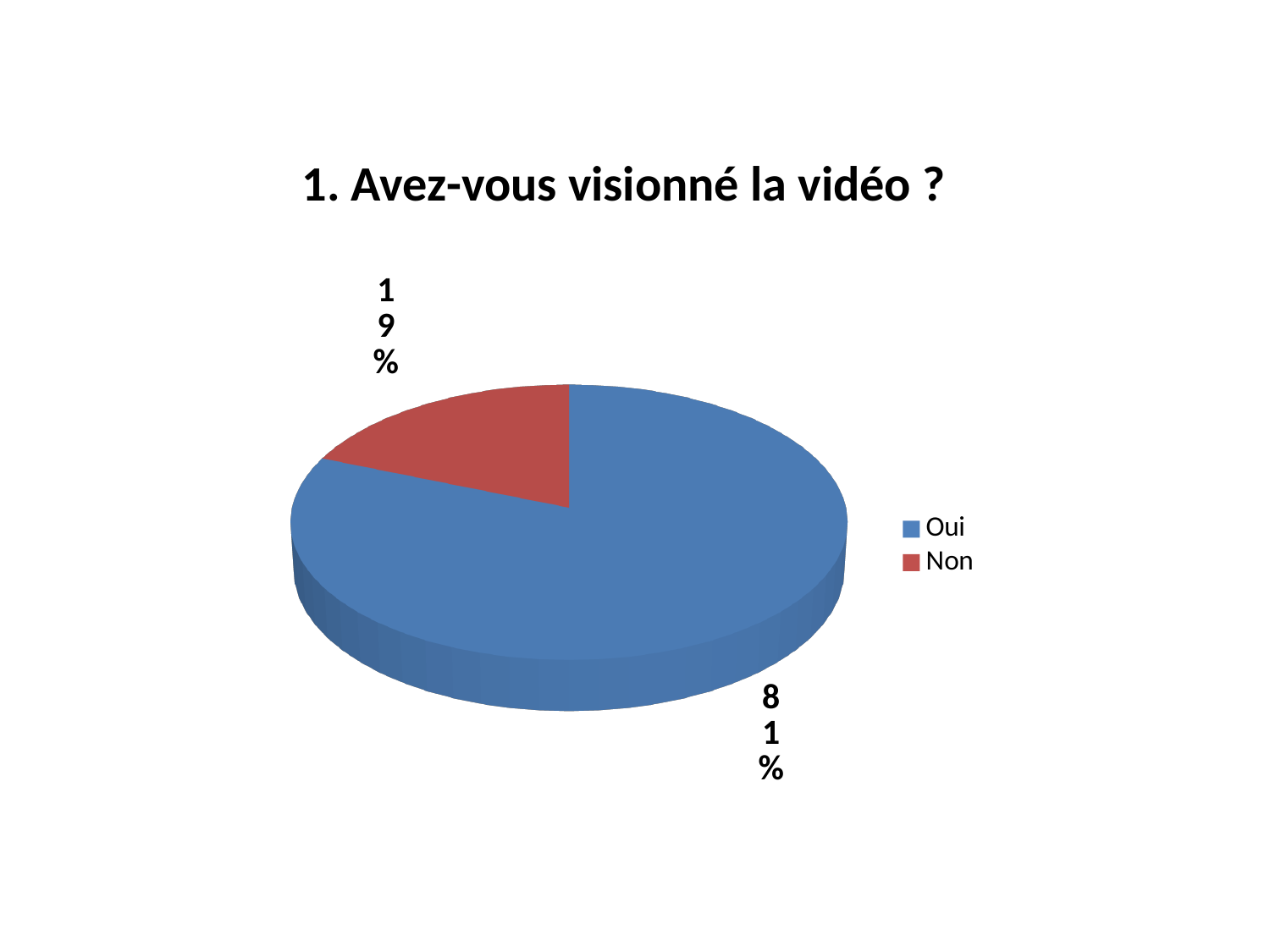
How many categories does the pie chart show? 2 What share of the pie does the Oui slice represent? 81% Is the share for Oui greater or less than 50%? greater What kind of chart is shown on the slide? Pie chart Which category has the smallest slice of the pie? Non Which slice is larger, Oui or Non? Oui Which category has the largest slice of the pie? Oui What share of the pie does the Non slice represent? 19% What colour is the Non slice in the pie chart? Red What is the title of the chart? 1. Avez-vous visionné la vidéo ? What is the difference in percentage points between the Oui and Non slices? 62